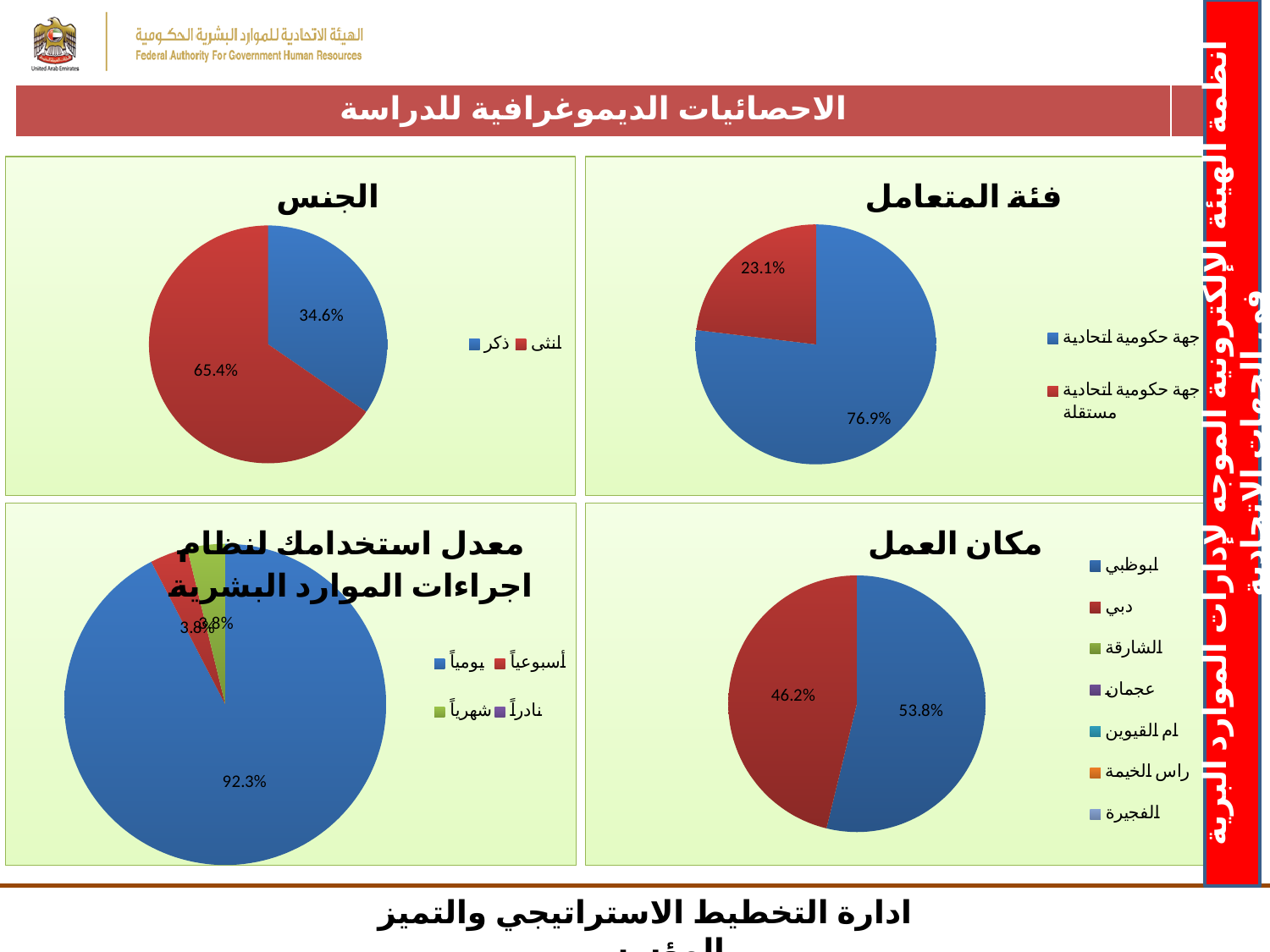
In the chart titled الجنس, what percentage is shown for the red slice? 65.4% In the chart titled فئة المتعامل, which slice is larger, the blue one or the red one? The blue one In the chart titled مكان العمل, what is the difference between the blue slice and the red slice? 7.6% What type of charts are shown on the slide? Pie charts In the chart titled الجنس, what percentage is shown for the blue slice? 34.6% In the chart titled معدل استخدامك لنظام اجراءات الموارد البشرية, how many entries does the legend list? 4 In the chart titled مكان العمل, how many entries does the legend list? 7 In the chart titled الجنس, what is the difference between the two slices? 30.8% How many charts are on the slide? 4 In the chart titled معدل استخدامك لنظام اجراءات الموارد البشرية, what percentage is shown for the largest slice? 92.3% In the chart titled مكان العمل, what percentage is shown for the red slice? 46.2% In the chart titled فئة المتعامل, what percentage is shown for the blue slice? 76.9%